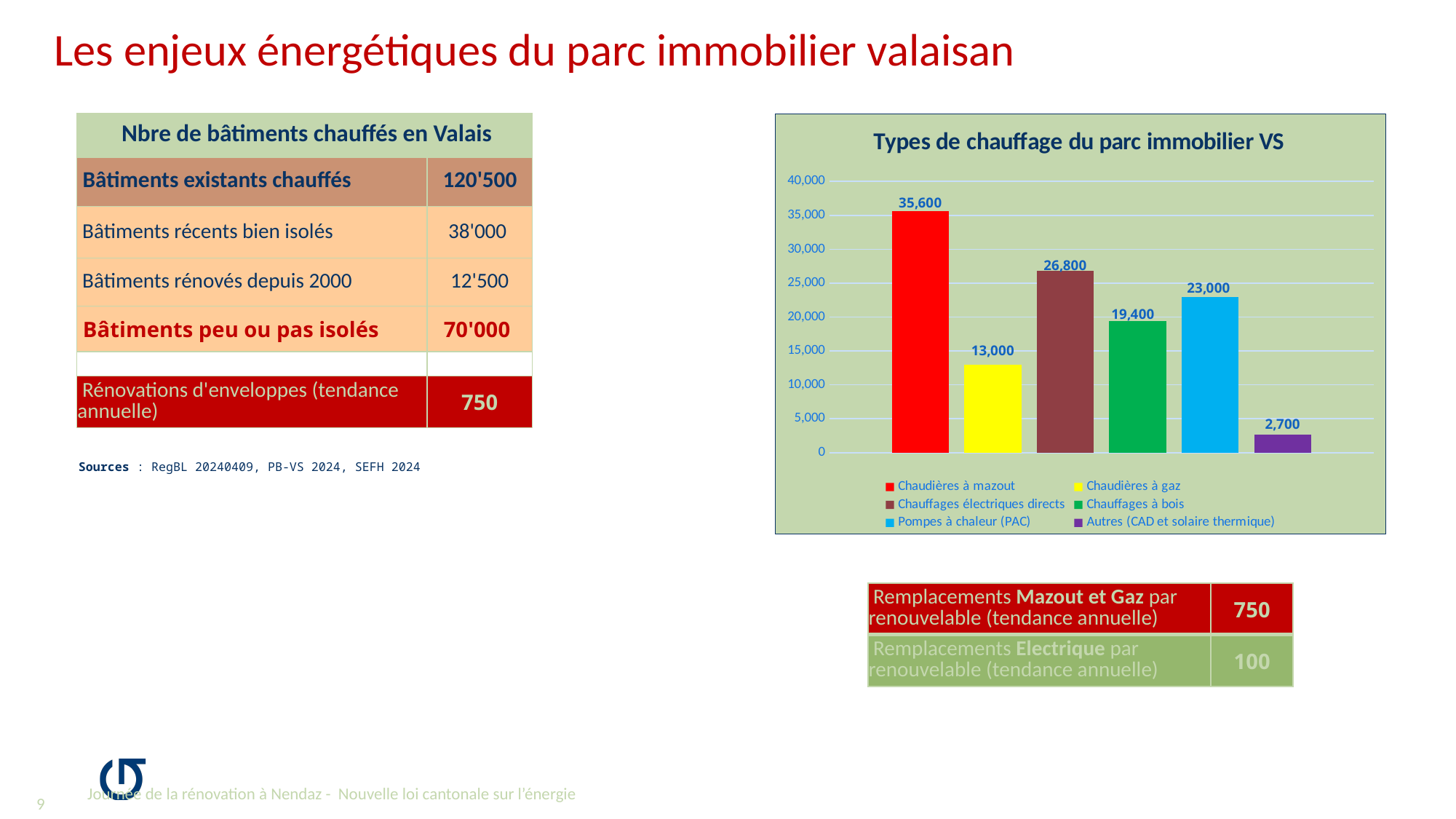
What is the value for Pompes à chaleur (PAC) in the chart? 23,000 How many heating types are shown in the chart? 6 Which heating type has the lowest value in the chart? Autres (CAD et solaire thermique) What is the value for Chaudières à mazout in the chart 'Types de chauffage du parc immobilier VS'? 35,600 What is the difference between Chaudières à mazout and Chaudières à gaz in the chart? 22,600 What is the difference between Chauffages électriques directs and Pompes à chaleur (PAC)? 3,800 What is the value for Chauffages à bois in the chart? 19,400 What kind of chart is 'Types de chauffage du parc immobilier VS'? bar chart What colour is the bar for Chauffages à bois in the chart? green Is the value for Chaudières à gaz greater or less than 15,000? less Which heating type has the highest value in the chart? Chaudières à mazout Which is larger in the chart: Chauffages électriques directs or Chauffages à bois? Chauffages électriques directs